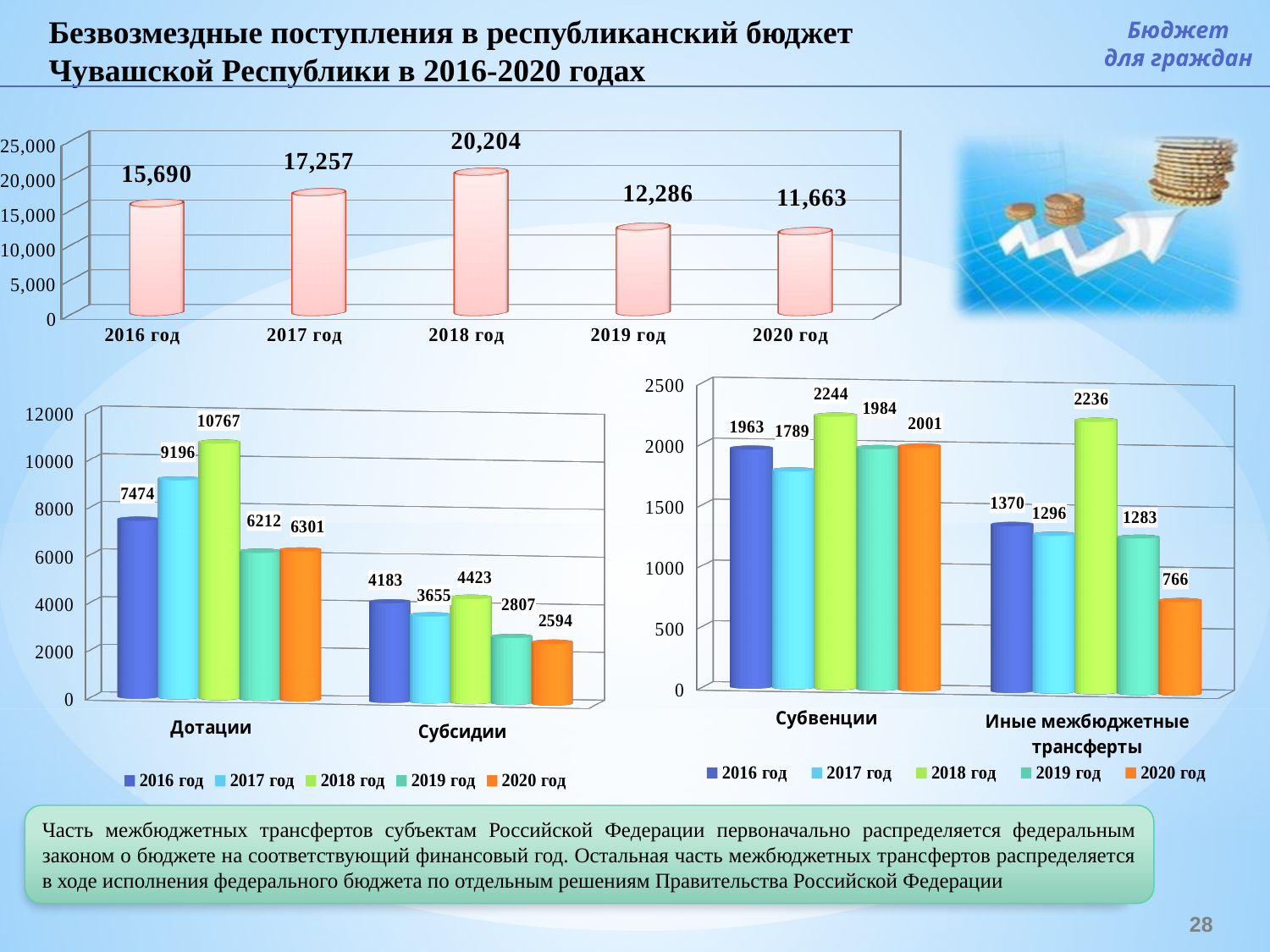
In the top chart, what is the difference between the values for 2018 год and 2019 год? 7,918 In the bottom-right chart, what is the value for Иные межбюджетные трансферты in 2020 год? 766 In the bottom-left chart, what is the value for Субсидии in 2020 год? 2594 In the top chart, what is the value for 2018 год? 20,204 In the bottom-left chart, what is the value for Дотации in 2018 год? 10767 What kind of chart is the top chart? Bar chart In the top chart, which year has the lowest value? 2020 год In the bottom-left chart, which is larger for Субсидии: 2016 год or 2017 год? 2016 год In the bottom-right chart, what is the difference between Субвенции in 2018 год and 2017 год? 455 In the top chart, how many years are plotted? 5 In the bottom-right chart, which year has the highest value for Субвенции? 2018 год In the bottom-left chart, how many series does the legend list? 5